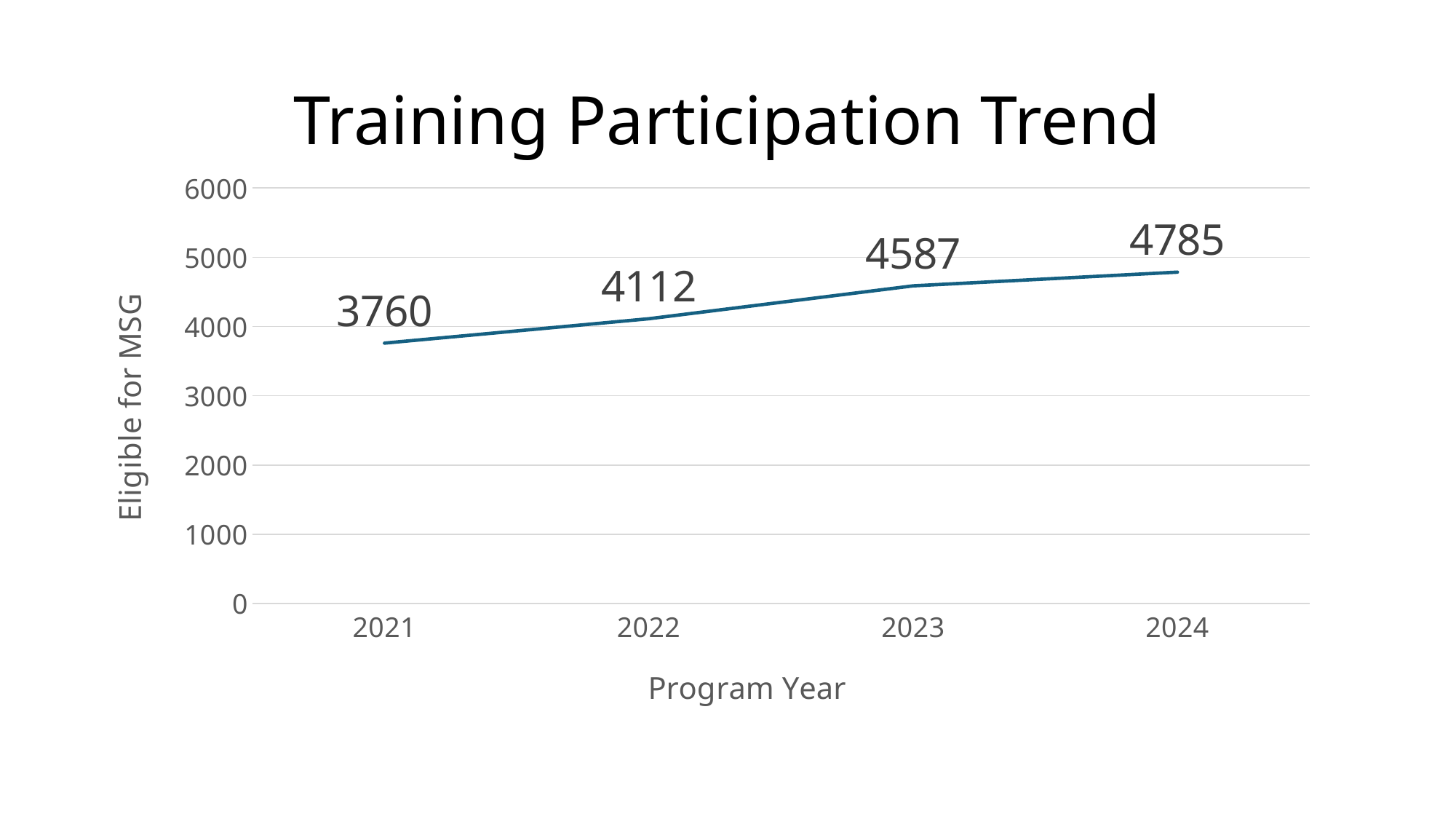
Which is larger, the value for 2022 or the value for 2023? 2023 What is the difference between the values for 2023 and 2022? 475 What is the value for 2021? 3760 What kind of chart is shown? line chart Do the values rise or fall from 2021 to 2024? rise What is the value for 2024? 4785 Which year has the highest value? 2024 What is the difference between the values for 2024 and 2021? 1025 Which year has the lowest value? 2021 What is the value for 2023? 4587 How many data points are plotted on the chart? 4 What is the value for 2022? 4112